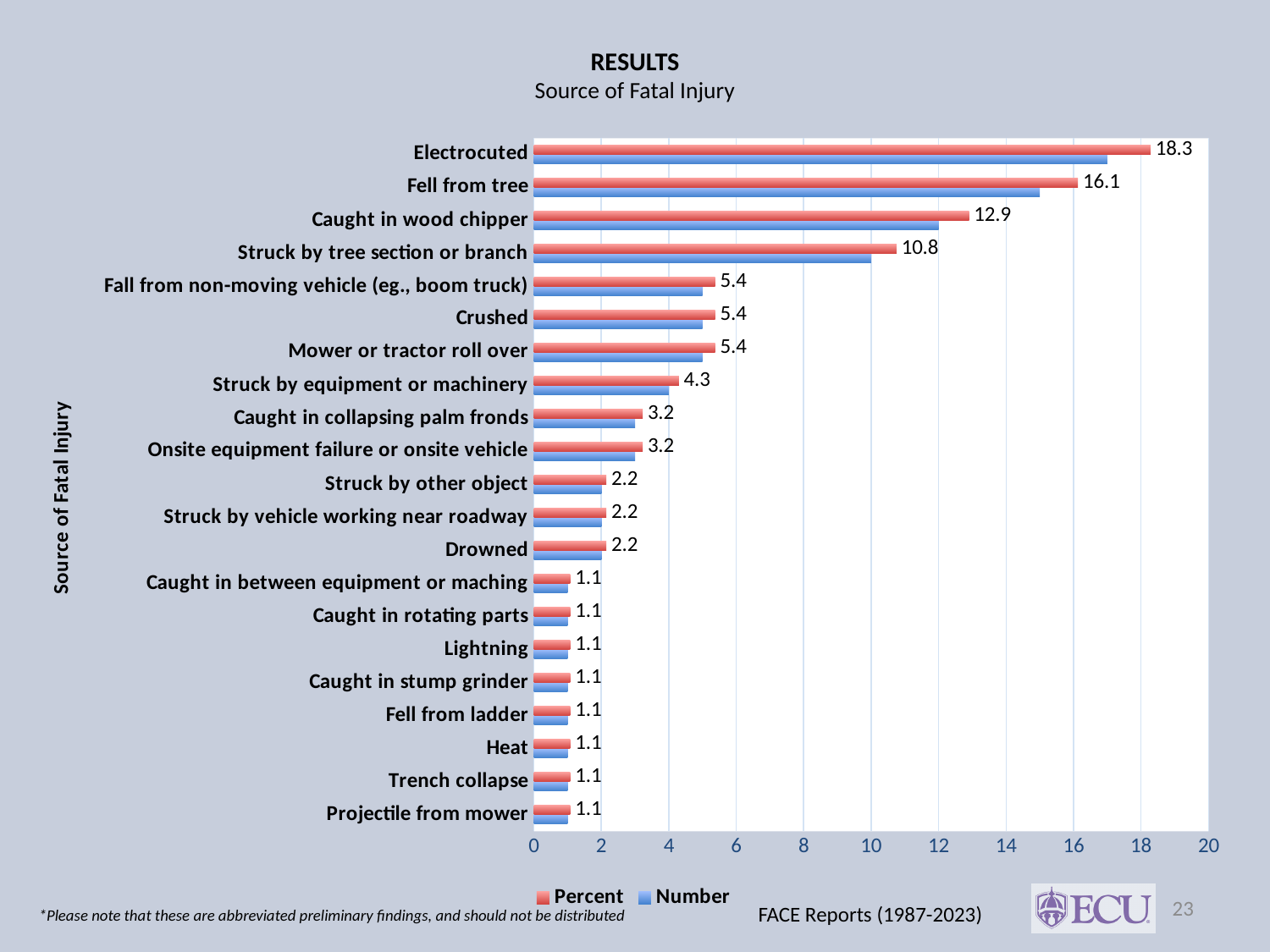
Which source of fatal injury has the highest Percent value? Electrocuted Which has a larger Percent value, Struck by tree section or branch or Crushed? Struck by tree section or branch Is the Number value for Electrocuted greater or less than 16? greater Is the Number value for Fell from tree greater or less than 16? less What is the Percent value for Caught in wood chipper? 12.9 How many sources of fatal injury are listed on the chart? 21 What type of chart is shown on the slide? Bar chart How many series does the legend list? 2 What is the difference between the Percent values for Electrocuted and Fell from tree? 2.2 What is the Percent value for Struck by equipment or machinery? 4.3 What is the Percent value for Electrocuted? 18.3 What is the difference between the Percent values for Caught in wood chipper and Struck by tree section or branch? 2.1